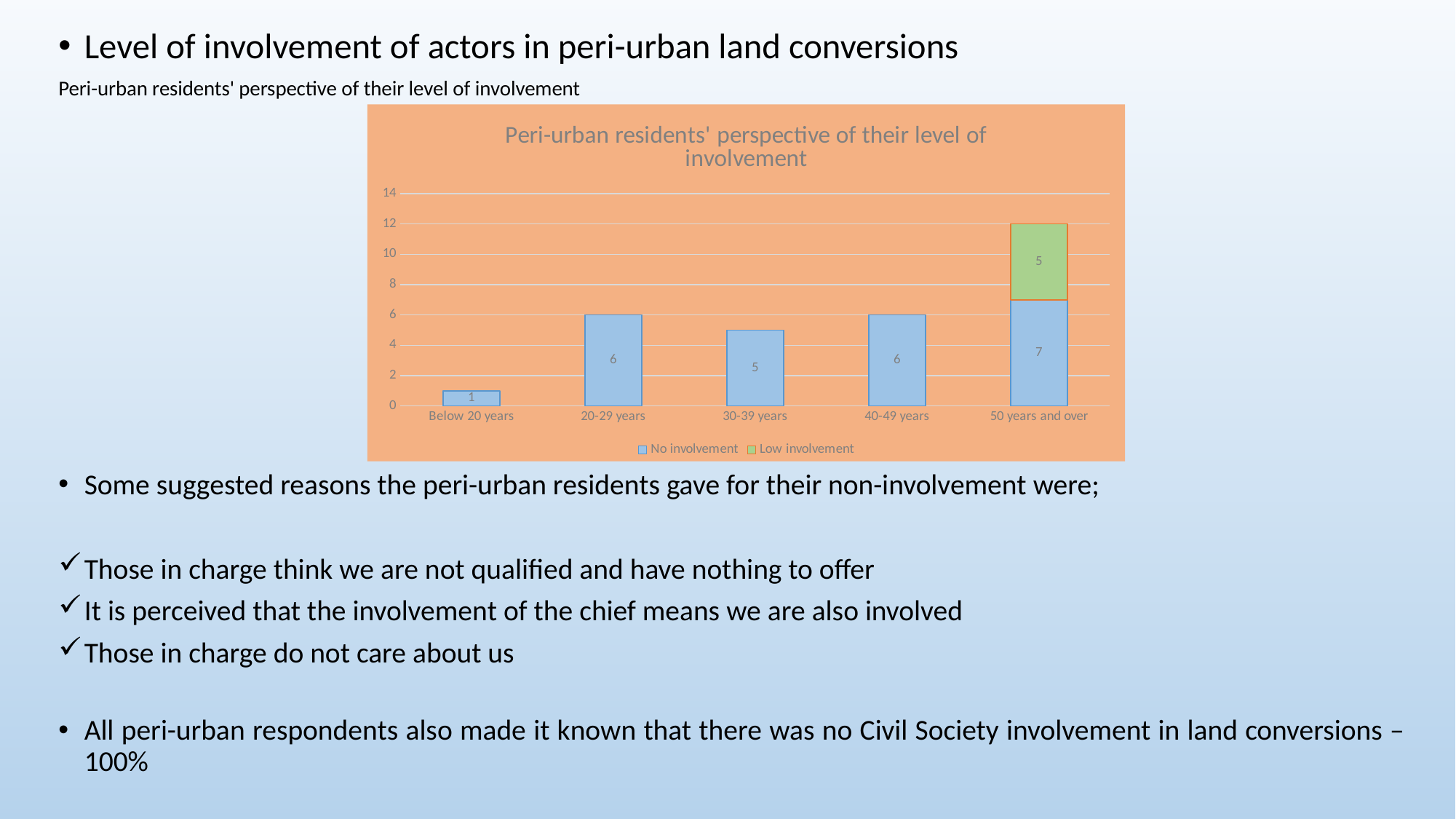
How many series does the legend list? 2 What kind of chart is shown on the slide? Stacked bar chart What is the total of the stacked bar for 50 years and over? 12 What is the difference between the 'No involvement' values for 50 years and over and 30-39 years? 2 What is the title of the chart? Peri-urban residents' perspective of their level of involvement How many age groups are shown on the x axis? 5 What is the 'No involvement' value for the Below 20 years group? 1 What is the 'Low involvement' value for the 50 years and over group? 5 Which has a larger 'No involvement' value, 20-29 years or 30-39 years? 20-29 years Which age group has the lowest 'No involvement' value? Below 20 years What is the 'No involvement' value for the 20-29 years group? 6 Which age group has the highest 'No involvement' value? 50 years and over